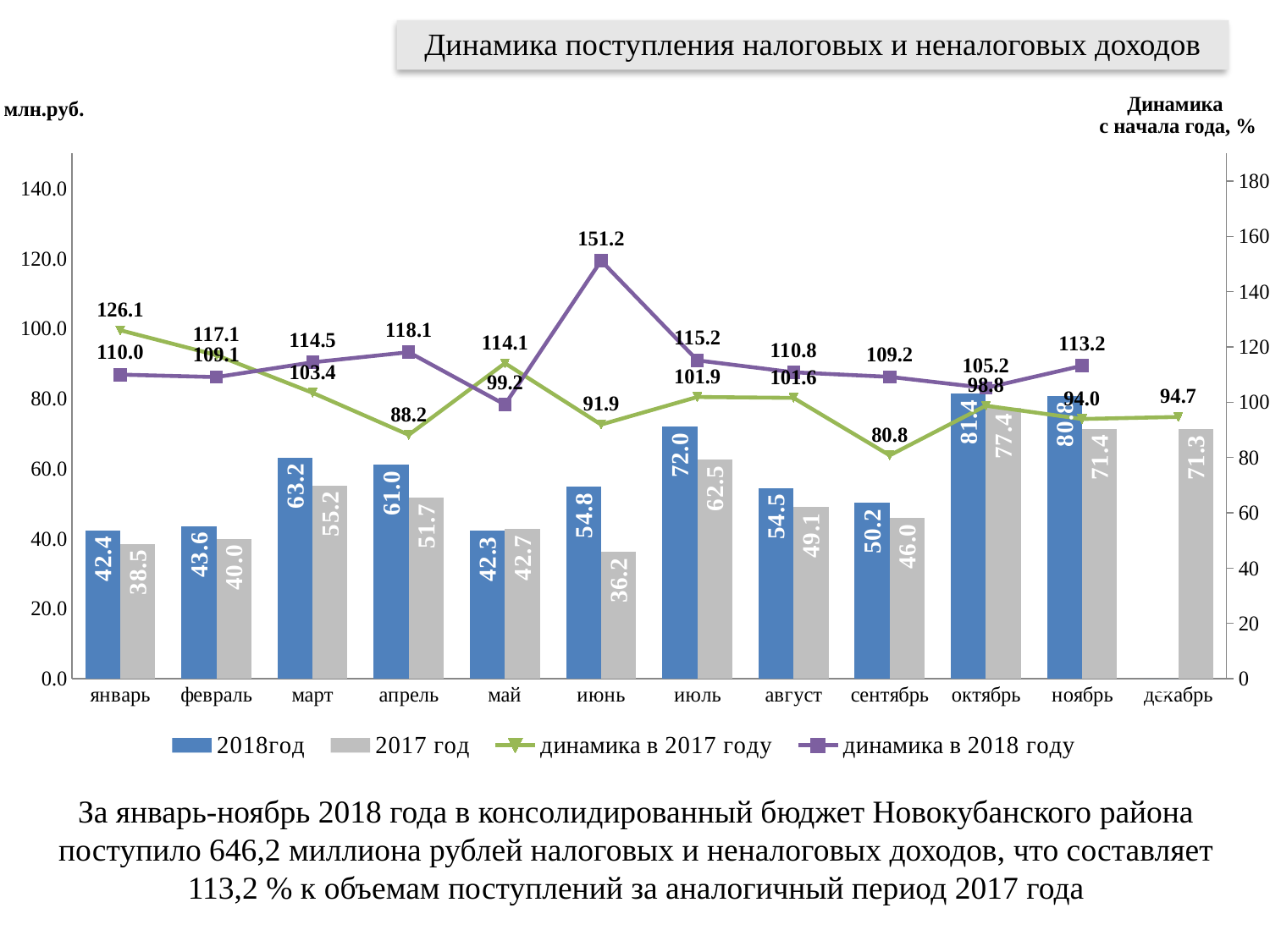
What is the difference between the 2018 год and 2017 год bars for март? 8.0 Which month has the highest value on the динамика в 2017 году line? январь What is the value of the динамика в 2018 году line for июнь? 151.2 What is the value of the 2017 год bar for июнь? 36.2 How many months are shown on the x axis? 12 What is the value of the динамика в 2017 году line for сентябрь? 80.8 What is the value of the динамика в 2018 году line for ноябрь? 113.2 Which is larger for май: the 2018 год bar or the 2017 год bar? 2017 год Which month has the lowest 2017 год bar? июнь Which month has the highest 2018 год bar? октябрь What is the value of the 2018 год bar for июль? 72.0 How many series does the legend list? 4